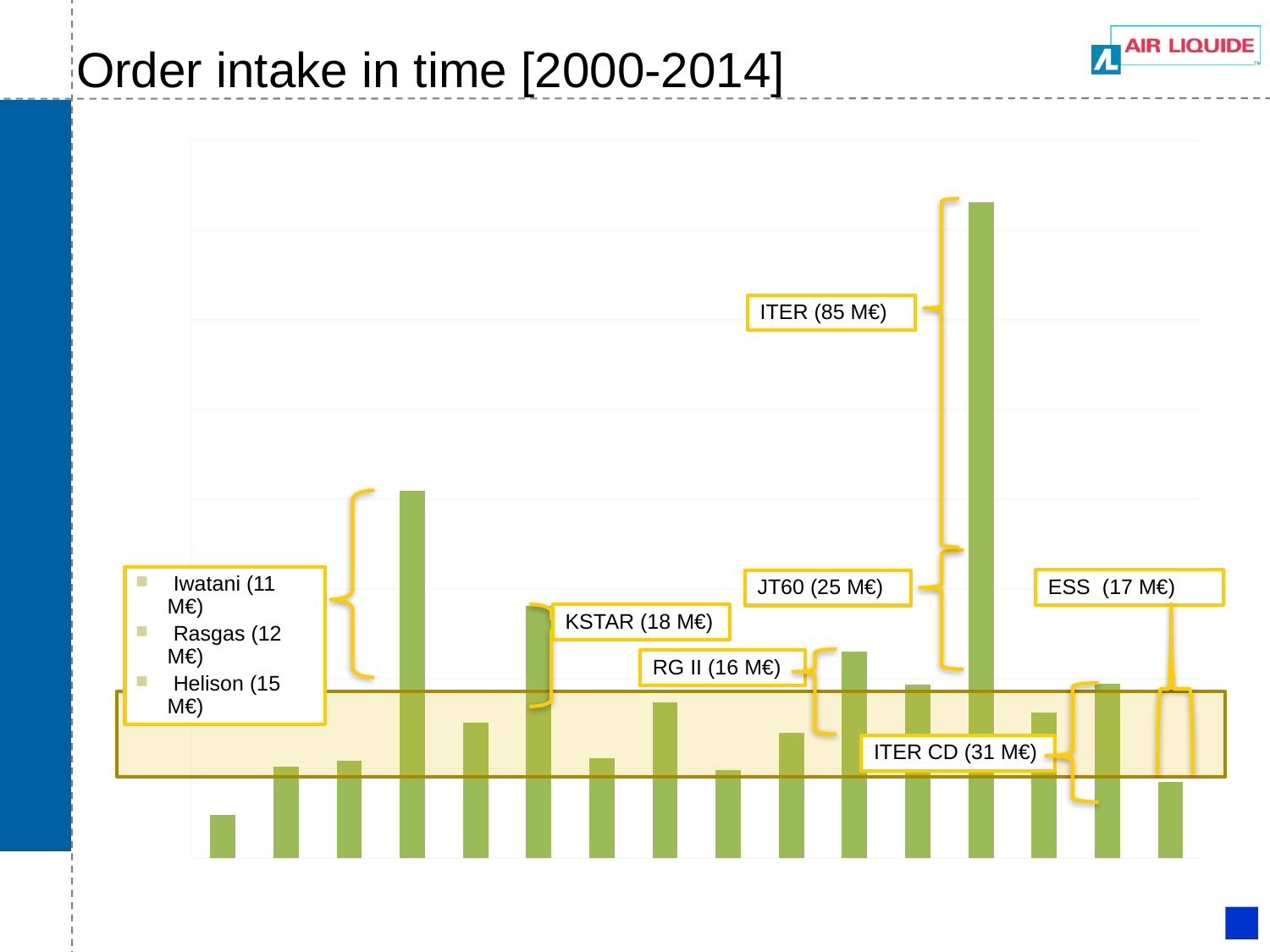
Which of the three projects listed in the left-hand box (Iwatani, Rasgas, Helison) has the smallest annotated value? Iwatani (11 M€) What value is given in the annotation for KSTAR? 18 M€ What value is given in the annotation for JT60? 25 M€ What value is given in the annotation for ESS? 17 M€ What is the difference between the annotated values for ITER (85 M€) and ITER CD (31 M€)? 54 M€ What is the title of the slide? Order intake in time [2000-2014] What kind of chart is shown on the slide? bar chart Which annotated project has the larger value, ITER or JT60? ITER What value is given in the annotation for RG II? 16 M€ What value is given in the annotation for ITER CD? 31 M€ What value is given in the annotation for ITER? 85 M€